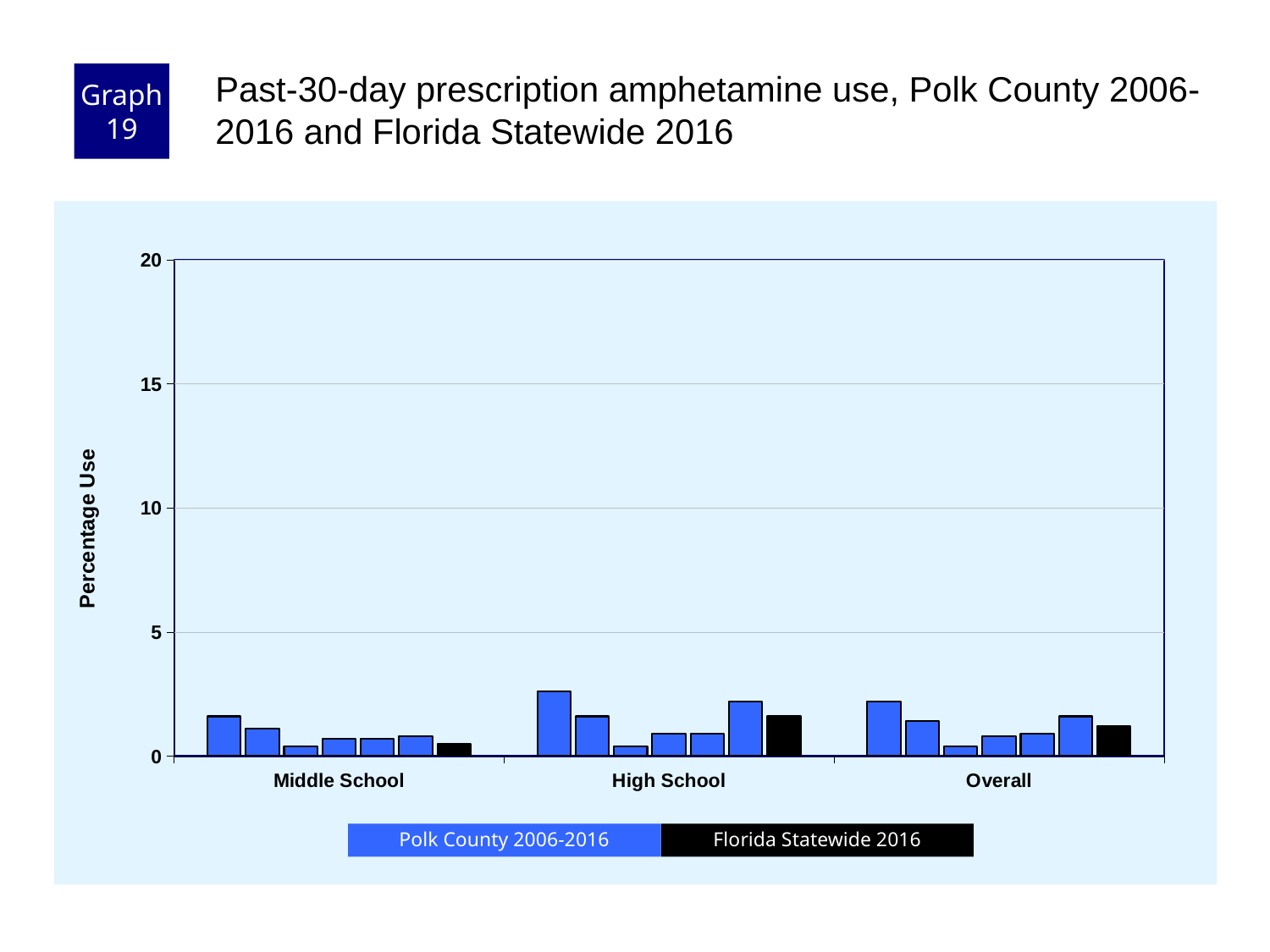
Which category contains the tallest bar in the chart? High School What is the label on the y axis? Percentage Use Is the tallest Polk County 2006-2016 bar for High School greater or less than 5? less How many bars are plotted in the Middle School group? 7 What is the title of the chart? Past-30-day prescription amphetamine use, Polk County 2006-2016 and Florida Statewide 2016 Is the Florida Statewide 2016 value larger for High School or for Middle School? High School Which category has the lowest Florida Statewide 2016 value? Middle School Is the Florida Statewide 2016 value for High School greater or less than 5? less What kind of chart is shown on the slide? bar chart How many series does the legend list? 2 Is the Florida Statewide 2016 value for Overall greater or less than 10? less How many categories are shown on the x axis? 3